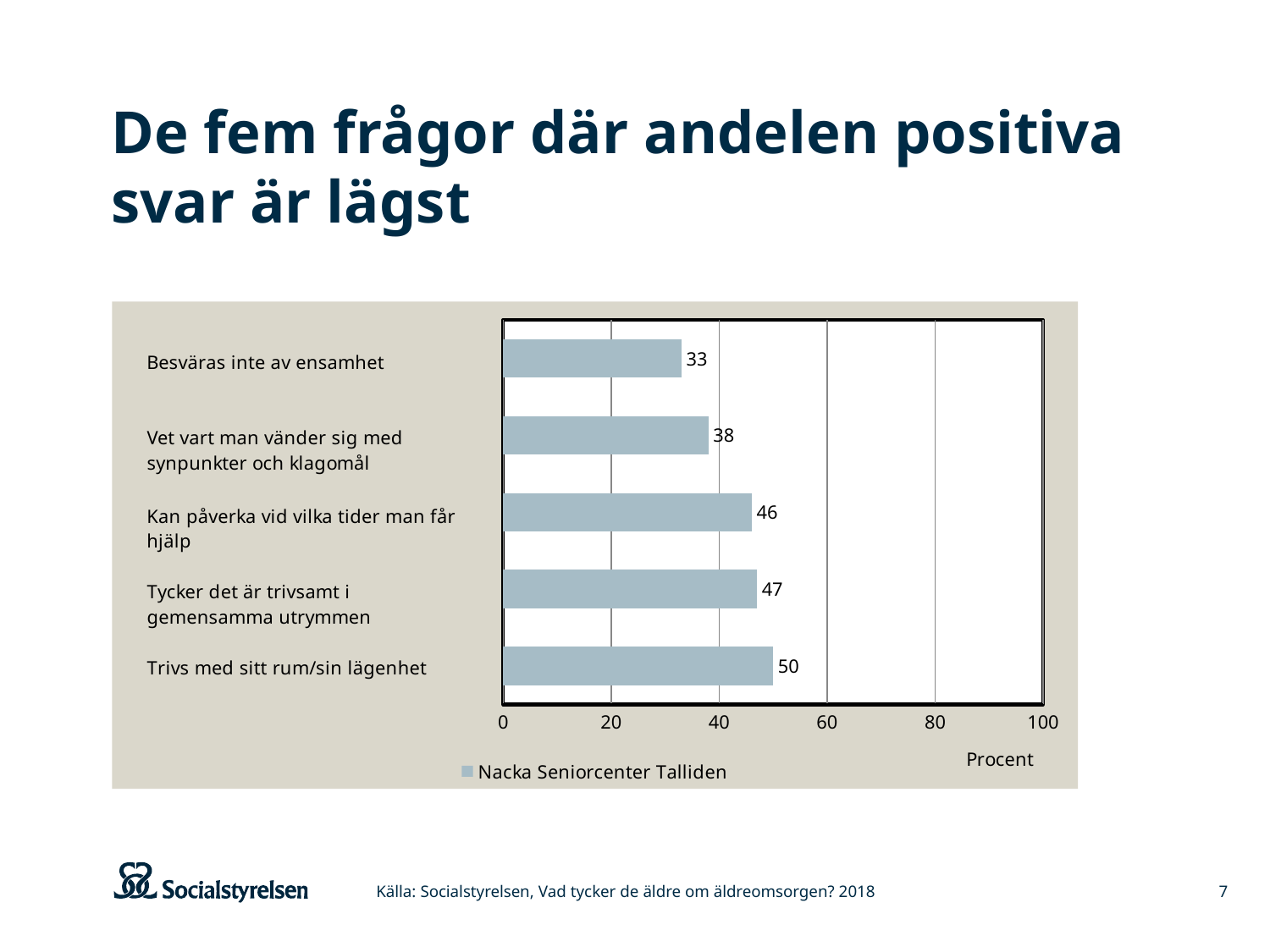
How many categories are shown in the chart? 5 What is the value for "Besväras inte av ensamhet"? 33 Which category has the lowest value? Besväras inte av ensamhet What kind of chart is shown on the slide? bar chart Which is larger: the value for "Vet vart man vänder sig med synpunkter och klagomål" or the value for "Kan påverka vid vilka tider man får hjälp"? Kan påverka vid vilka tider man får hjälp Is the value for "Tycker det är trivsamt i gemensamma utrymmen" greater or less than 40? greater Which category has the highest value? Trivs med sitt rum/sin lägenhet What is the value for "Trivs med sitt rum/sin lägenhet"? 50 What is the name of the series in the legend? Nacka Seniorcenter Talliden What is the difference between the values for "Trivs med sitt rum/sin lägenhet" and "Besväras inte av ensamhet"? 17 How many series does the legend list? 1 What is the value for "Kan påverka vid vilka tider man får hjälp"? 46